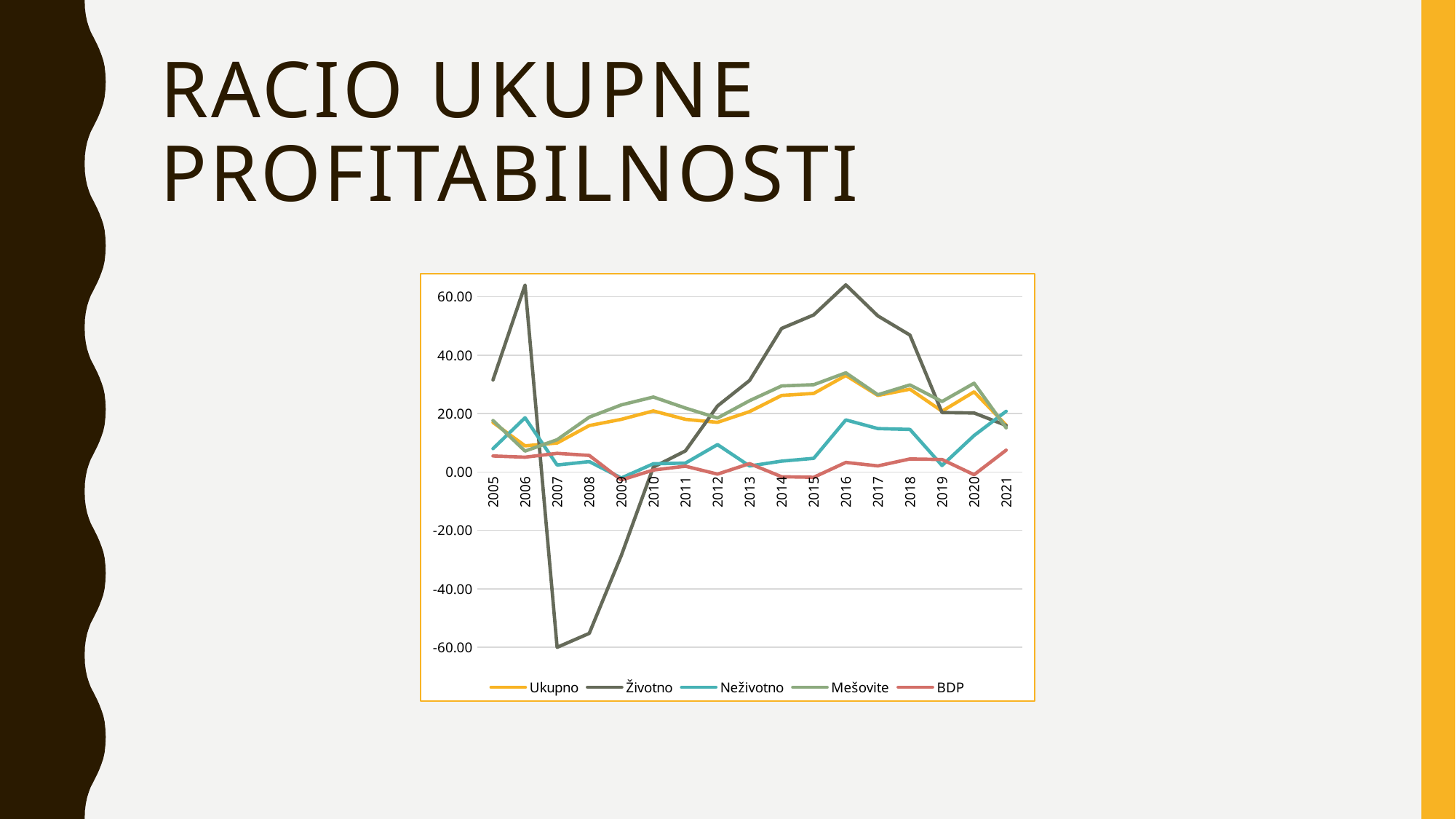
In 2007, which is larger: Životno or Neživotno? Neživotno In which year does the Životno series reach its lowest value? 2007 Is the value for Mešovite in 2010 greater or less than 20.00? greater Is the value for Životno in 2016 greater or less than 60.00? greater How many years are shown on the x axis? 17 Is the value for BDP in 2021 greater or less than 0.00? greater What kind of chart is shown on the slide? line chart Which series reaches the highest value anywhere on the chart? Životno How many series does the legend list? 5 Which series are listed in the legend? Ukupno, Životno, Neživotno, Mešovite, BDP Does the Životno series rise or fall from 2016 to 2019? fall